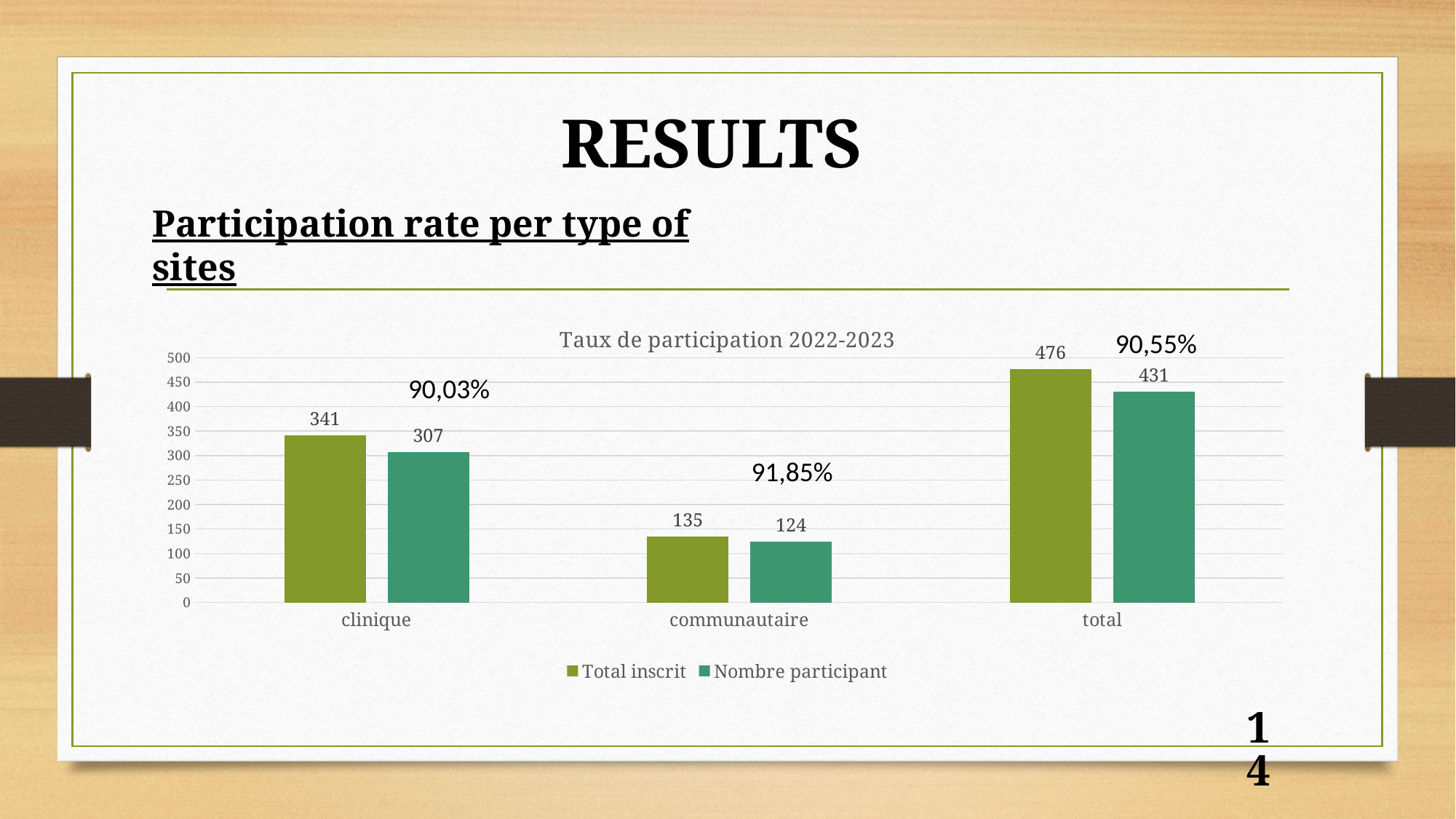
Which category has the highest Nombre participant value? total Which is larger, Total inscrit for clinique or Nombre participant for total? Nombre participant for total How many series does the legend list? 2 What is the difference between Total inscrit and Nombre participant for total? 45 What is the difference between Total inscrit and Nombre participant for clinique? 34 What is the title of the chart? Taux de participation 2022-2023 Which category has the lowest Total inscrit value? communautaire What is the value of Total inscrit for clinique? 341 How many categories are shown on the x axis? 3 What is the value of Nombre participant for communautaire? 124 What is the value of Nombre participant for total? 431 What kind of chart is shown on the slide? bar chart